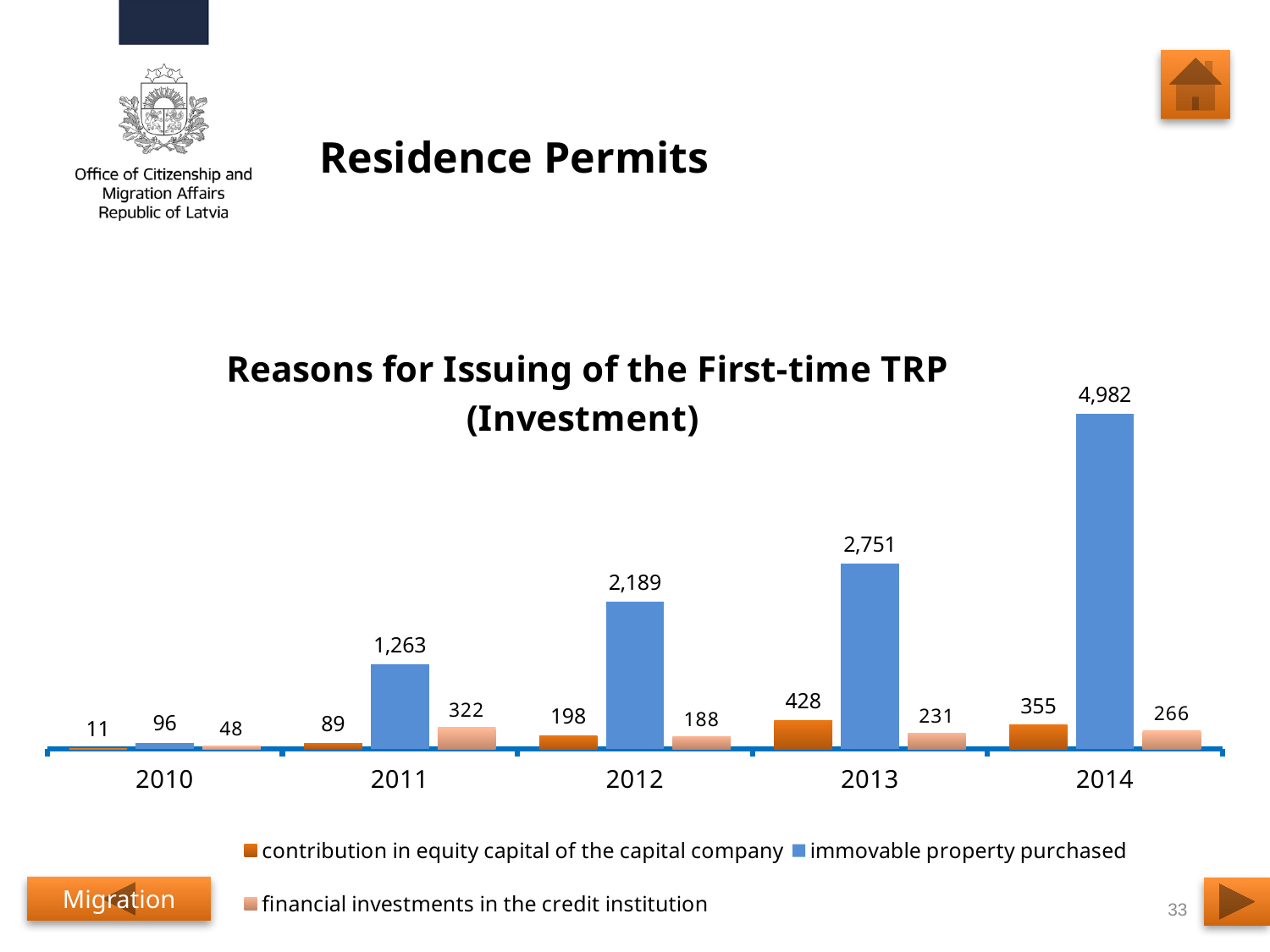
Which is larger in 2012: contribution in equity capital of the capital company or financial investments in the credit institution? contribution in equity capital of the capital company What is the difference between the immovable property purchased values for 2014 and 2013? 2,231 How many series does the legend list? 3 What is the value for immovable property purchased in 2014? 4,982 Does the value for immovable property purchased rise or fall from 2010 to 2014? rise What is the title of the chart? Reasons for Issuing of the First-time TRP (Investment) In which year is the value for contribution in equity capital of the capital company the lowest? 2010 What is the value for financial investments in the credit institution in 2011? 322 What kind of chart is shown on the slide? bar chart What is the value for contribution in equity capital of the capital company in 2013? 428 In which year is the value for immovable property purchased the highest? 2014 How many years are shown on the x axis? 5